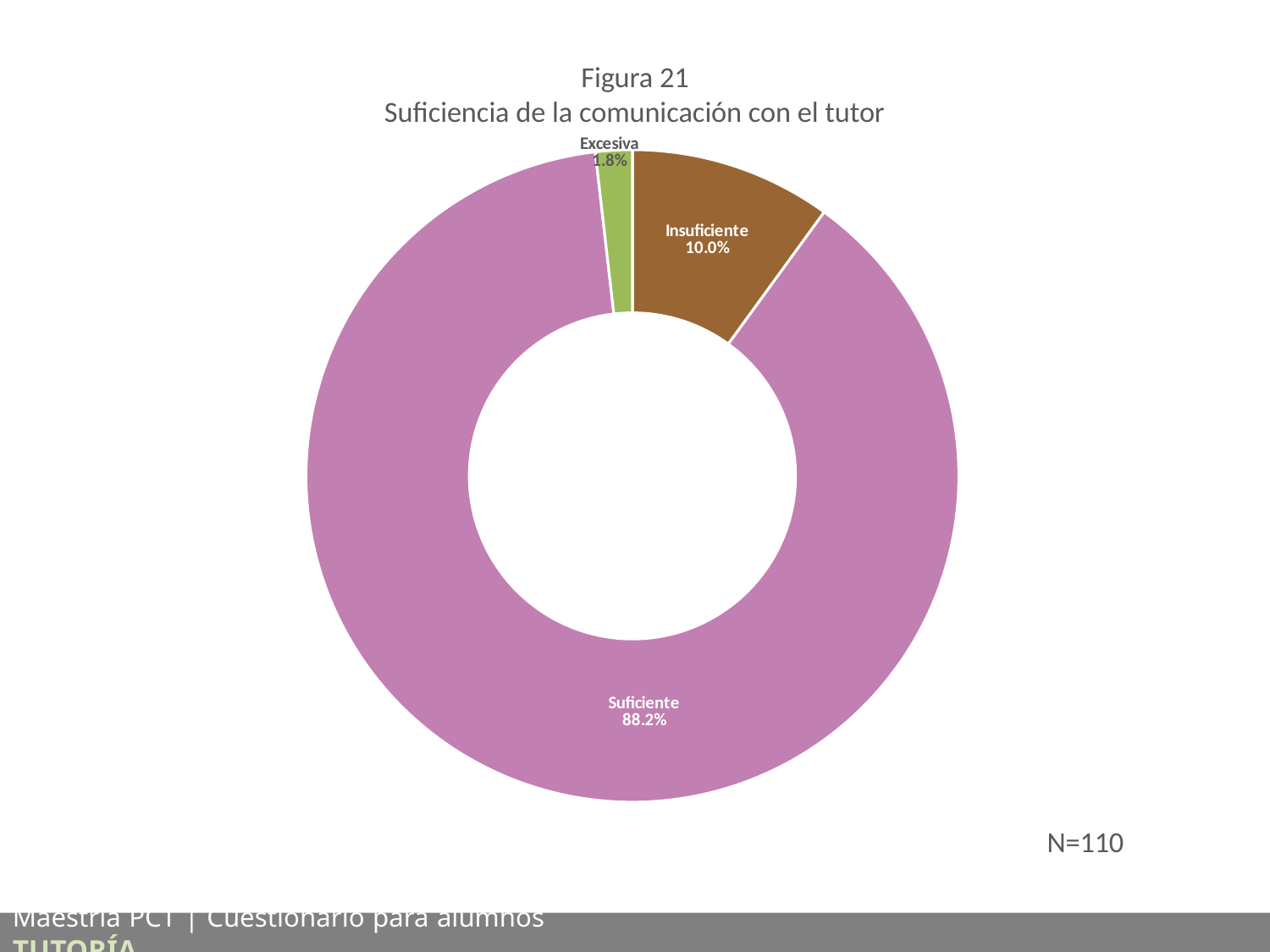
What is the difference in percentage points between "Suficiente" and "Insuficiente"? 78.2 Which category has the largest share of the chart? Suficiente What is the difference in percentage points between "Insuficiente" and "Excesiva"? 8.2 Which is larger, the share for "Insuficiente" or the share for "Excesiva"? Insuficiente What is the sample size (N) shown on the slide? N=110 Which category has the smallest share of the chart? Excesiva What percentage of respondents answered "Suficiente"? 88.2% What is the title of the chart? Figura 21 Suficiencia de la comunicación con el tutor What percentage of respondents answered "Insuficiente"? 10.0% How many categories are shown in the chart? 3 What percentage of respondents answered "Excesiva"? 1.8% What kind of chart is shown on the slide? Pie chart (doughnut)